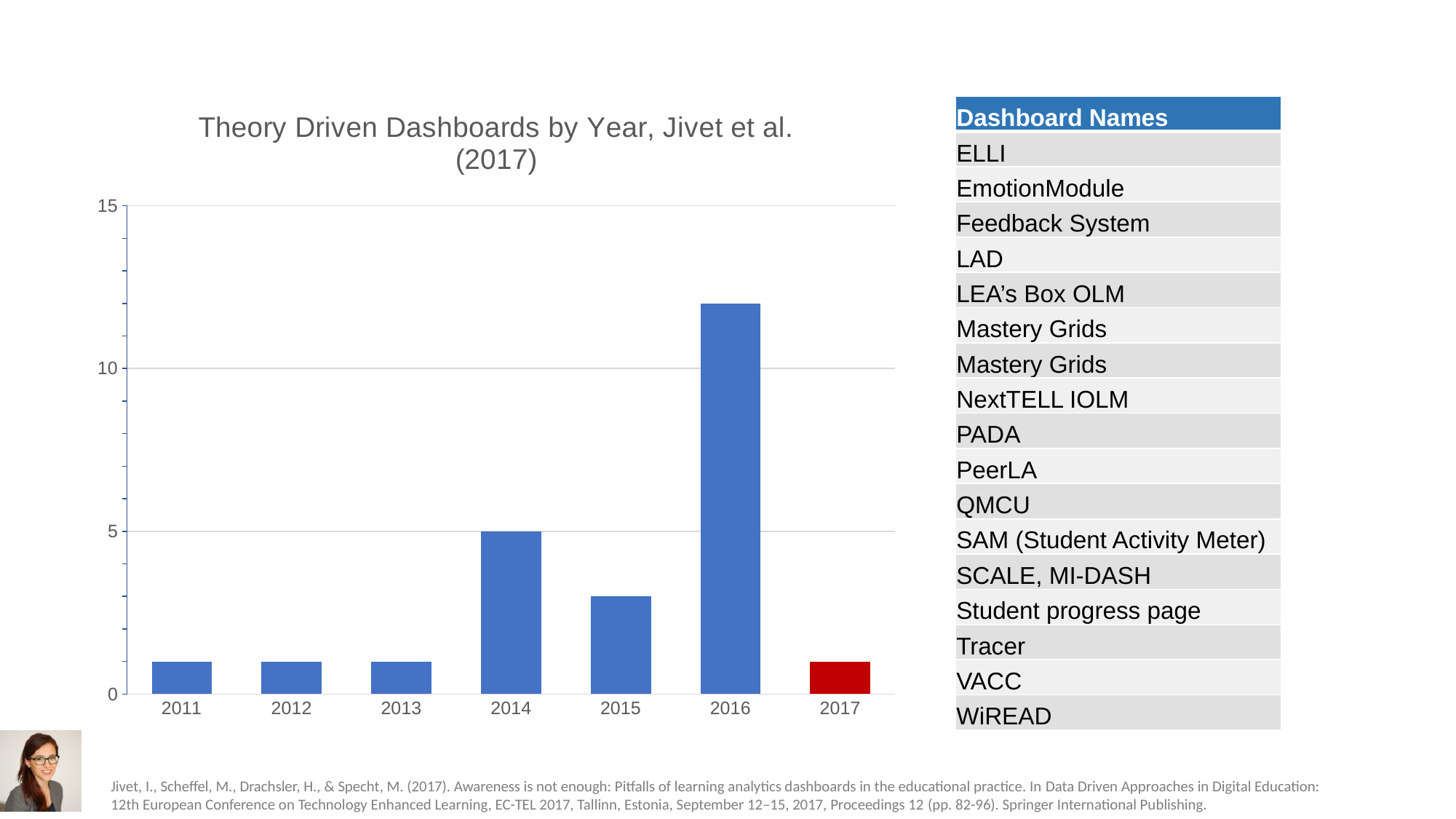
Which year has the highest bar in the chart? 2016 Is the value for 2011 greater or less than 5? less Is the value for 2015 greater or less than 5? less How many years are shown on the x axis of the chart? 7 Is the value for 2016 greater or less than 10? greater What kind of chart is shown on the slide? bar chart What is the value for 2014 in the chart? 5 What is the title of the chart? Theory Driven Dashboards by Year, Jivet et al. (2017) Which year has the larger value, 2014 or 2015? 2014 Which year's bar is coloured red instead of blue? 2017